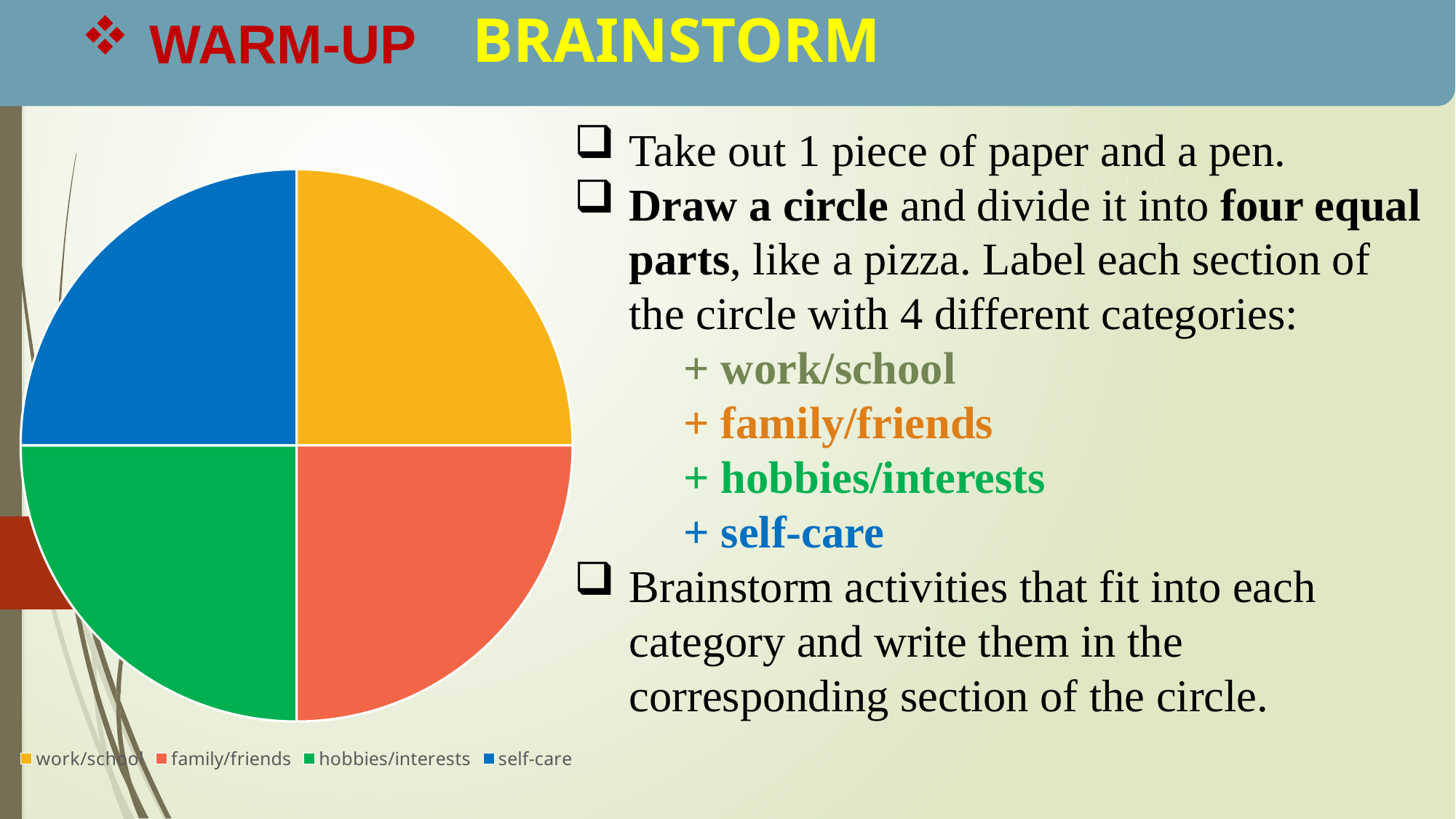
How many slices does the pie chart have? 4 What kind of chart is shown on the slide? pie chart Is the family/friends slice larger or smaller than the hobbies/interests slice? equal What share of the pie does the self-care slice take? 25% How many entries does the legend of the pie chart list? 4 Are the four slices of the pie chart equal in size? yes What share of the pie does the work/school slice take? 25% Which category is shown in blue in the pie chart? self-care Which legend entry is listed first in the pie chart's legend? work/school Which category is shown in green in the pie chart? hobbies/interests